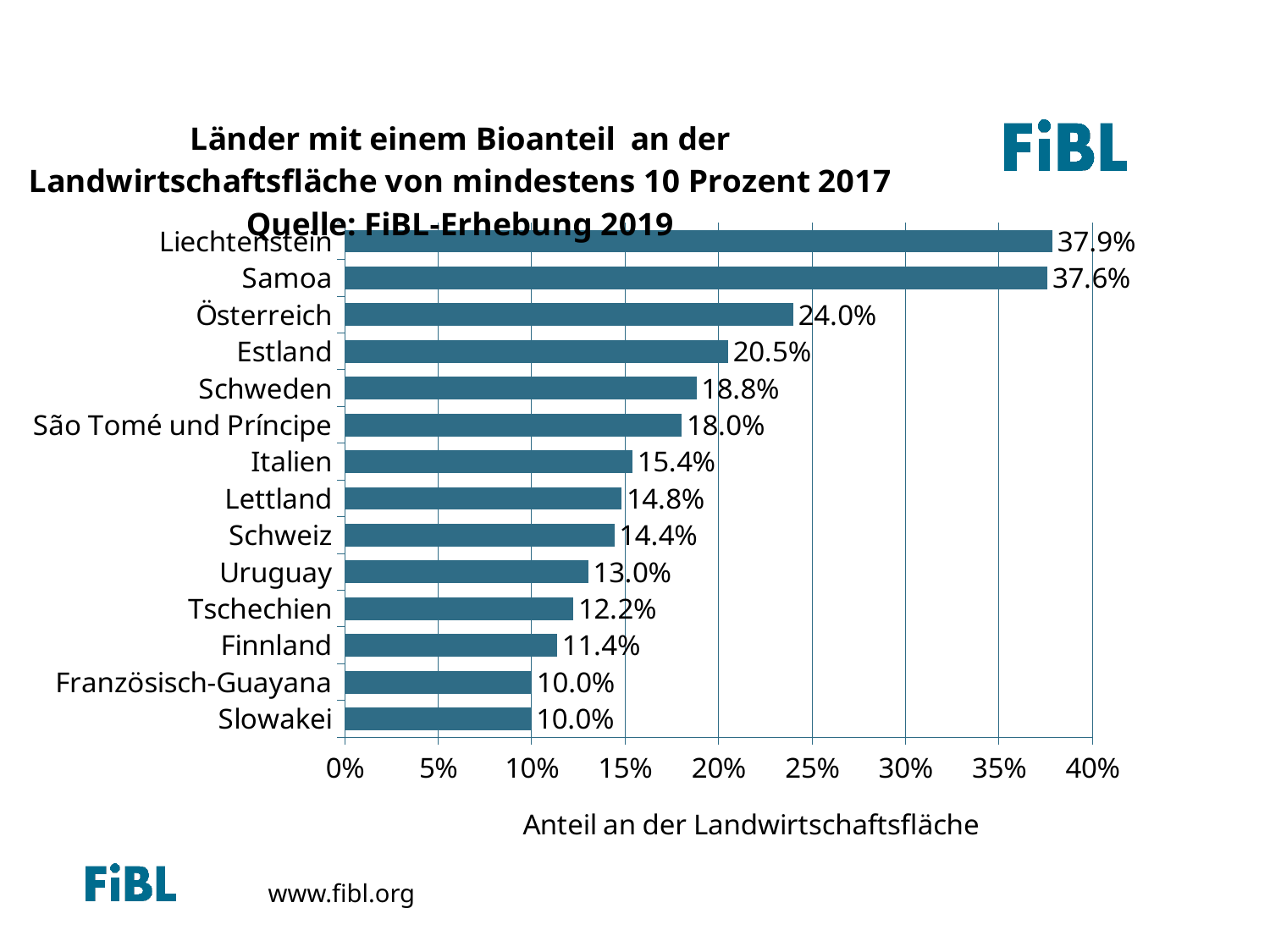
What is the value for Schweden? 18.8% How many countries are shown in the chart? 14 Which two countries share the lowest value of 10.0%? Französisch-Guayana and Slowakei Which is larger, the value for Lettland or the value for Schweiz? Lettland Which country has the highest share? Liechtenstein What is the difference between the values for Estland and Italien? 5.1% What kind of chart is shown on the slide? bar chart What is the value for Österreich? 24.0% What is the label of the horizontal axis? Anteil an der Landwirtschaftsfläche What is the value for Uruguay? 13.0% What is the difference between the values for Liechtenstein and Samoa? 0.3% Is the value for São Tomé und Príncipe greater or less than 15%? greater